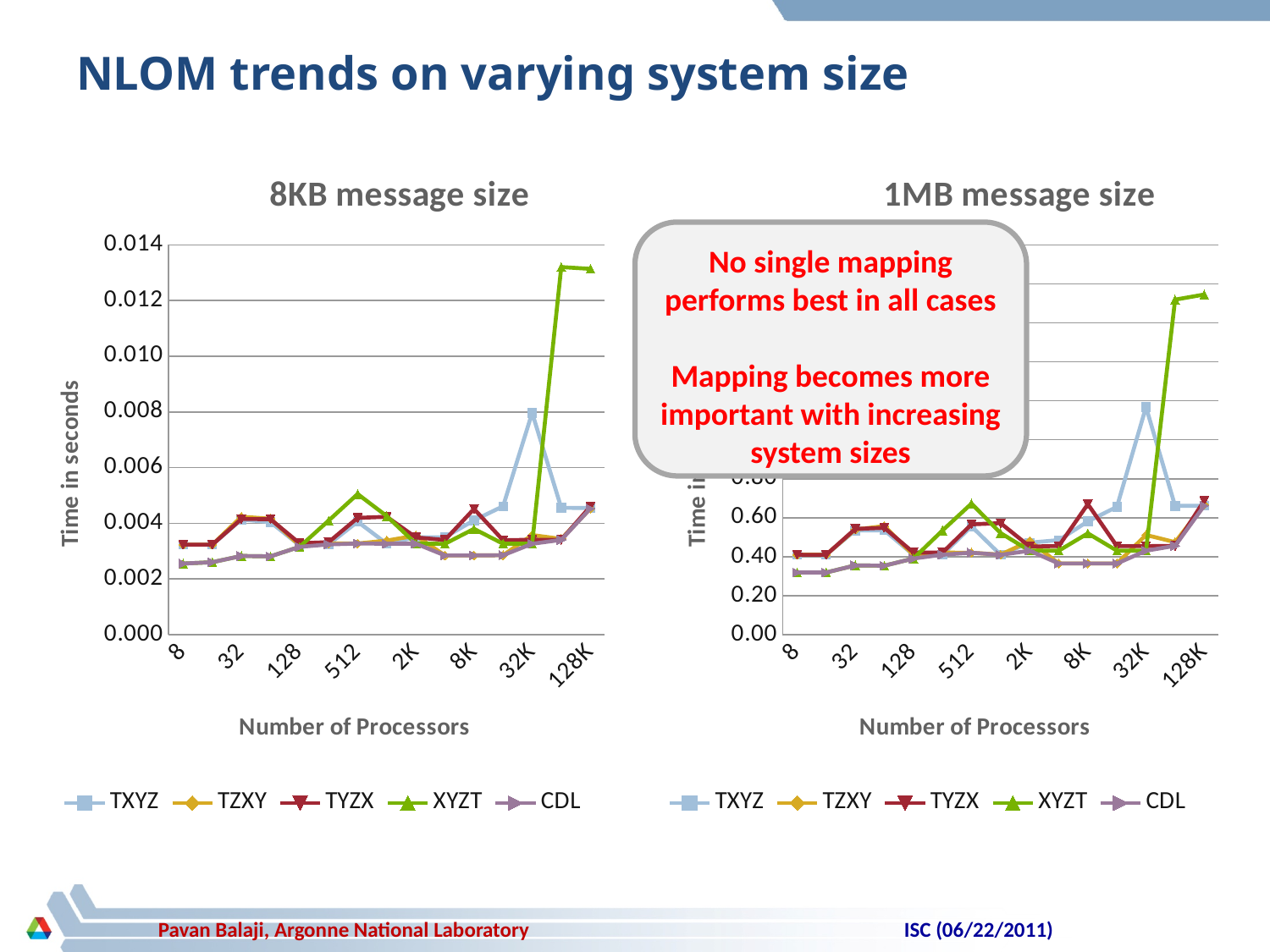
In the "1MB message size" chart, does the XYZT series rise or fall between 32K and 128K processors? rise In the "1MB message size" chart, is the value for TXYZ at 32K processors greater or less than 0.60? greater In the "1MB message size" chart, is the value for CDL at 8 processors greater or less than 0.40? less In the "8KB message size" chart, which series reaches the highest value on the chart? XYZT In the "8KB message size" chart, which is larger at 512 processors: XYZT or TYZX? XYZT In the "8KB message size" chart, which is larger at 32K processors: TXYZ or XYZT? TXYZ What is the x-axis label of the "8KB message size" chart? Number of Processors In the "1MB message size" chart, which series has the highest value at 128K processors? XYZT How many series does the legend of the "1MB message size" chart list? 5 What kind of chart is the "8KB message size" chart? line chart In the "8KB message size" chart, is the value for TXYZ at 32K processors greater or less than 0.006? greater